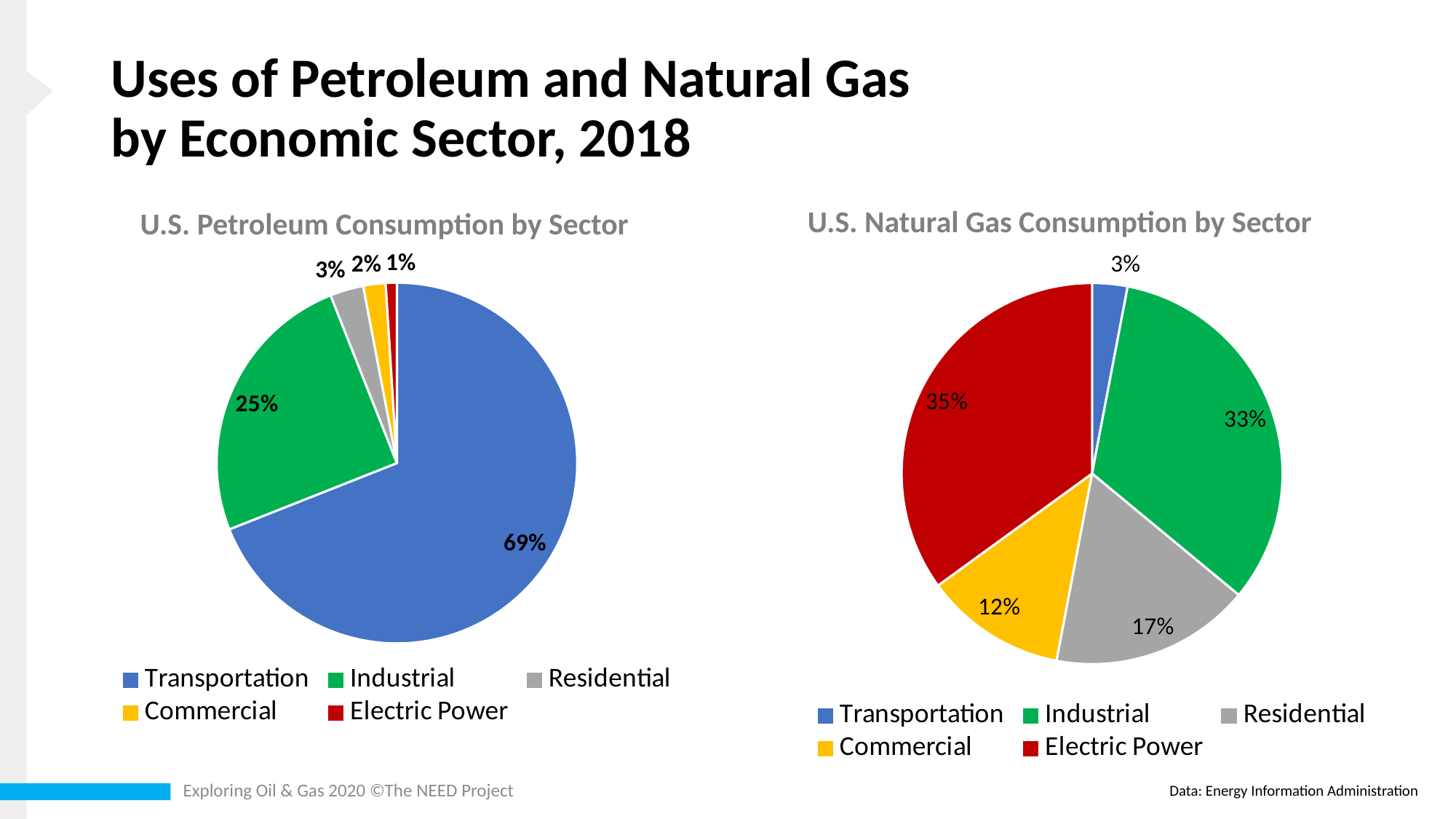
In the U.S. Petroleum Consumption by Sector chart, what share does Industrial have? 25% In the U.S. Petroleum Consumption by Sector chart, which sector has the smallest share? Electric Power In the U.S. Natural Gas Consumption by Sector chart, which sector has the smallest share? Transportation In the U.S. Natural Gas Consumption by Sector chart, what share does Electric Power have? 35% How many sectors are shown in the U.S. Petroleum Consumption by Sector chart? 5 In the U.S. Natural Gas Consumption by Sector chart, what share does Residential have? 17% What type of chart is the U.S. Natural Gas Consumption by Sector chart? Pie chart In the U.S. Petroleum Consumption by Sector chart, what share does Transportation have? 69% In the U.S. Natural Gas Consumption by Sector chart, which sector has the largest share? Electric Power In the U.S. Petroleum Consumption by Sector chart, what is the difference between the Transportation and Industrial shares? 44% In the U.S. Natural Gas Consumption by Sector chart, which is larger, Commercial or Residential? Residential In the U.S. Natural Gas Consumption by Sector chart, what colour represents Commercial? Yellow